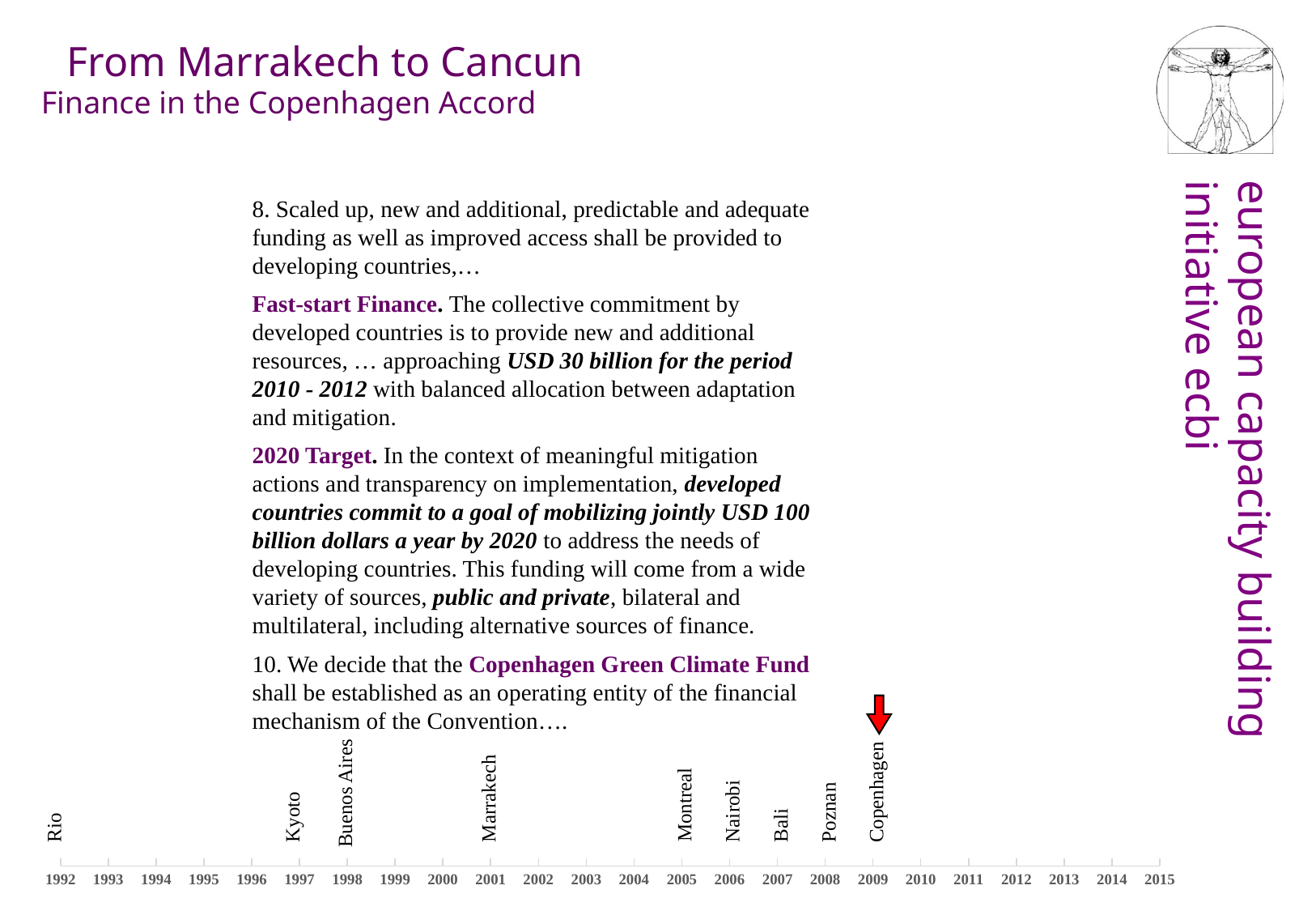
On the timeline at the bottom of the slide, which event is placed at 2008? Poznan On the timeline at the bottom of the slide, which year is Copenhagen placed at? 2009 On the timeline at the bottom of the slide, what is the last year shown on the axis? 2015 On the timeline at the bottom of the slide, which year is Rio placed at? 1992 On the timeline at the bottom of the slide, which year is Kyoto placed at? 1997 On the timeline at the bottom of the slide, which event is placed at 2007? Bali How many named events are labelled on the timeline at the bottom of the slide? 9 On the timeline at the bottom of the slide, which year is Marrakech placed at? 2001 What kind of graphic is shown at the bottom of the slide? timeline On the timeline at the bottom of the slide, which event comes immediately after Kyoto? Buenos Aires On the timeline at the bottom of the slide, which event does the red arrow point to? Copenhagen On the timeline at the bottom of the slide, what is the first year shown on the axis? 1992